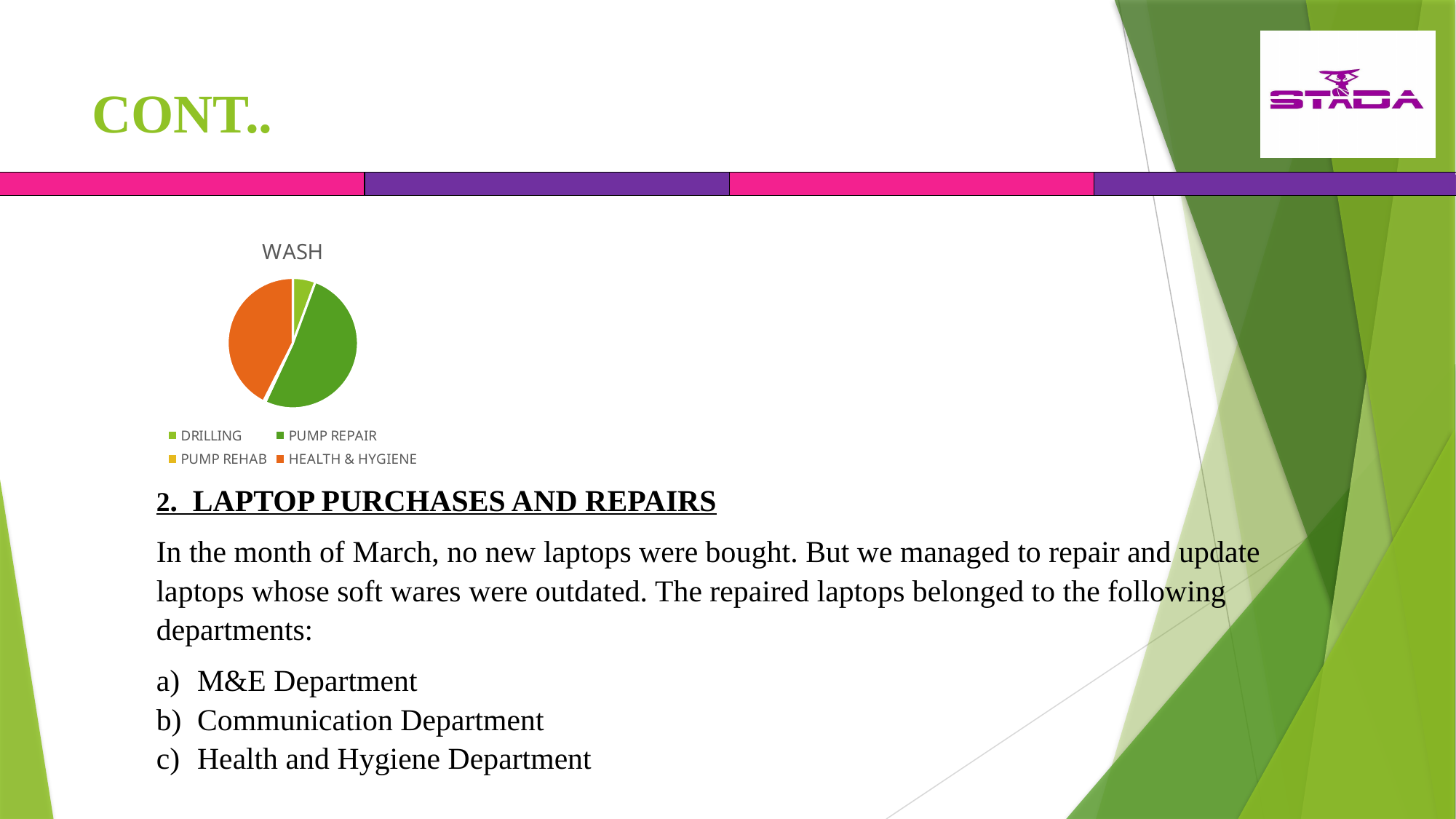
What colour represents HEALTH & HYGIENE in the WASH pie chart? orange Which category has the largest slice in the WASH pie chart? PUMP REPAIR What kind of chart is shown on the slide? pie chart In the WASH pie chart, which slice is larger: PUMP REPAIR or DRILLING? PUMP REPAIR What is the title of the pie chart? WASH In the WASH pie chart, which slice is larger: HEALTH & HYGIENE or DRILLING? HEALTH & HYGIENE How many categories does the legend of the WASH pie chart list? 4 In the WASH pie chart, which slice is larger: PUMP REPAIR or HEALTH & HYGIENE? PUMP REPAIR